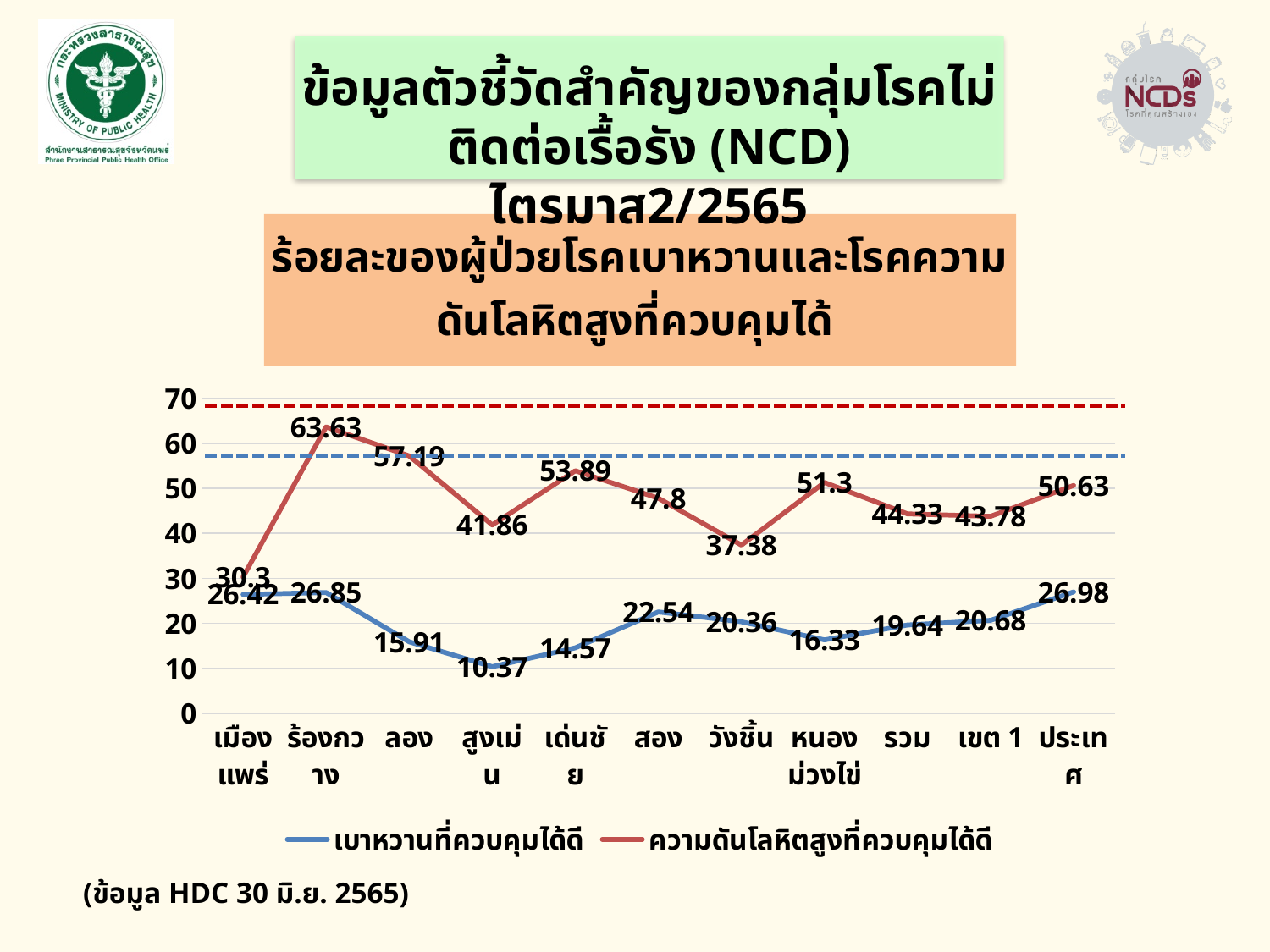
What is the difference between ความดันโลหิตสูงที่ควบคุมได้ดี and เบาหวานที่ควบคุมได้ดี for ประเทศ? 23.65 What type of chart is shown on the slide? line chart How many categories are shown on the x axis? 11 What is the value of เบาหวานที่ควบคุมได้ดี for สูงเม่น? 10.37 Which category has the highest value for ความดันโลหิตสูงที่ควบคุมได้ดี? ร้องกวาง What is the value of เบาหวานที่ควบคุมได้ดี for เขต 1? 20.68 What is the value of ความดันโลหิตสูงที่ควบคุมได้ดี for ร้องกวาง? 63.63 How many series does the legend list? 2 Which category has the lowest value for ความดันโลหิตสูงที่ควบคุมได้ดี? เมืองแพร่ What colour is the line for ความดันโลหิตสูงที่ควบคุมได้ดี? red Which category has the lowest value for เบาหวานที่ควบคุมได้ดี? สูงเม่น For ความดันโลหิตสูงที่ควบคุมได้ดี, which is larger: เด่นชัย or สอง? เด่นชัย